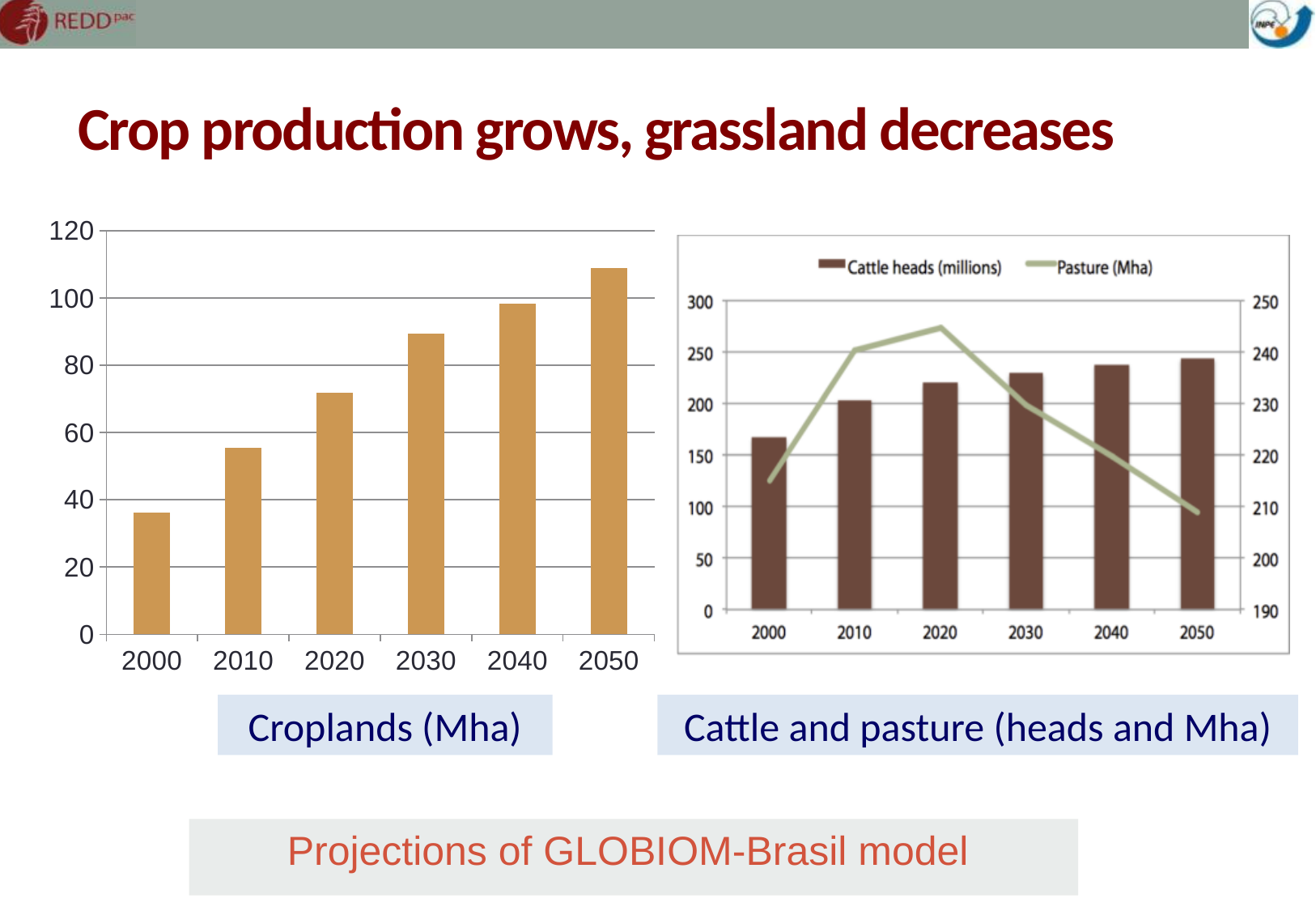
In the Cattle and pasture chart, is the Pasture (Mha) value for 2050 greater or less than 220? less What kind of chart is the Croplands (Mha) chart on the left? bar chart In the Croplands (Mha) chart, which year has the highest value? 2050 In the Cattle and pasture chart, is the Cattle heads (millions) value for 2000 greater or less than 150? greater In the Croplands (Mha) chart, is the value for 2000 greater or less than 40? less How many years are shown on the x axis of the Croplands (Mha) chart? 6 In the Croplands (Mha) chart, do the values rise or fall from 2000 to 2050? rise In the Cattle and pasture chart, in which year does the Pasture (Mha) line reach its highest point? 2020 In the Croplands (Mha) chart, which year has the lowest value? 2000 How many series does the legend of the Cattle and pasture chart on the right list? 2 In the Cattle and pasture chart, which year has the larger Cattle heads (millions) value, 2010 or 2050? 2050